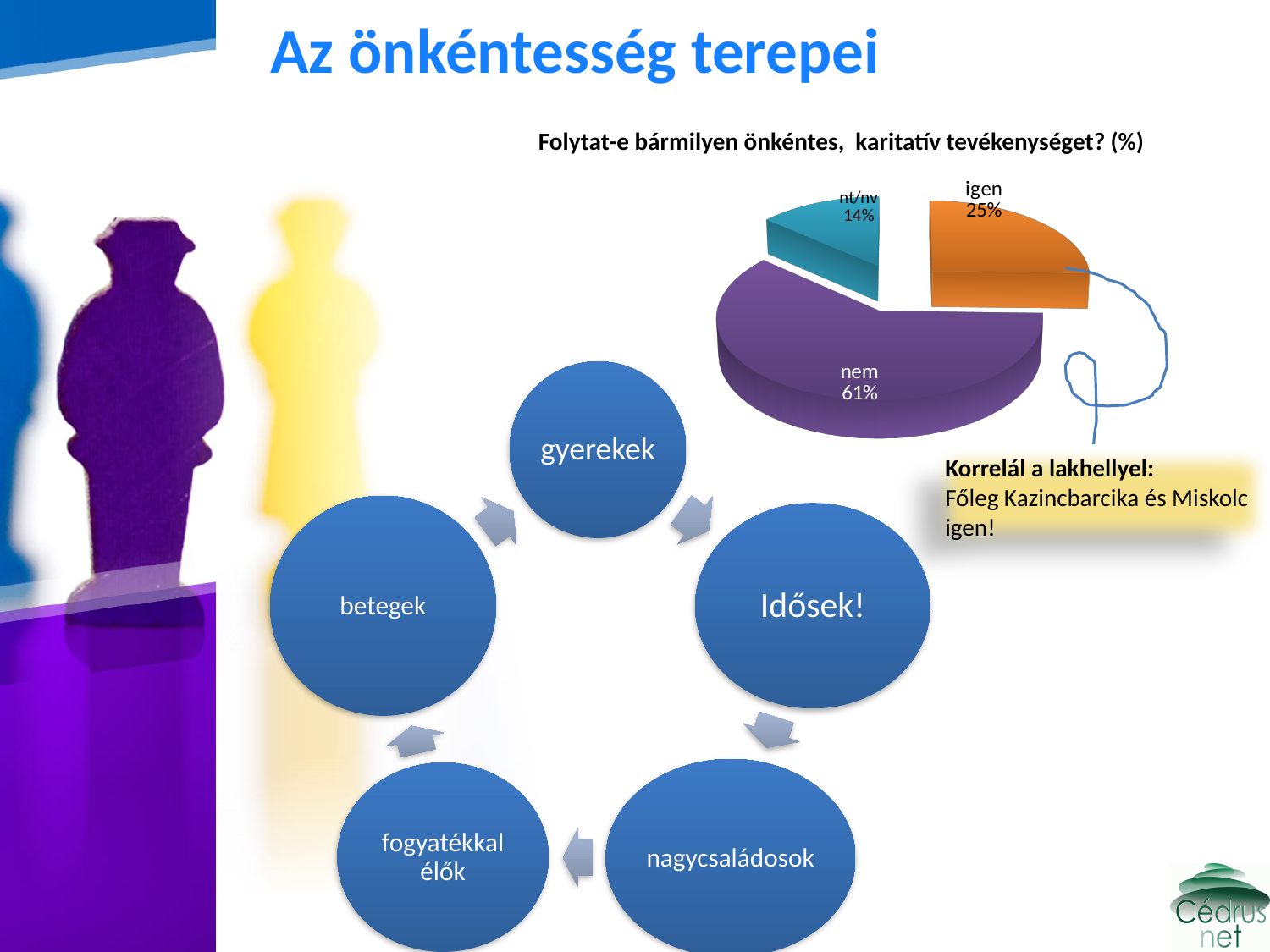
What is the title of the pie chart? Folytat-e bármilyen önkéntes, karitatív tevékenységet? (%) How many slices does the pie chart have? 3 Which slice of the pie chart is the largest? nem What share of the pie does the "nem" slice represent? 61% What is the value for "nem" in the pie chart? 61% What is the difference between the "igen" and "nt/nv" values in the pie chart? 11% What is the difference between the "nem" and "igen" values in the pie chart? 36% What kind of chart is shown on the slide? pie chart Which slice of the pie chart is the smallest? nt/nv What is the value for "igen" in the pie chart? 25% Which is larger in the pie chart, "igen" or "nt/nv"? igen What is the value for "nt/nv" in the pie chart? 14%